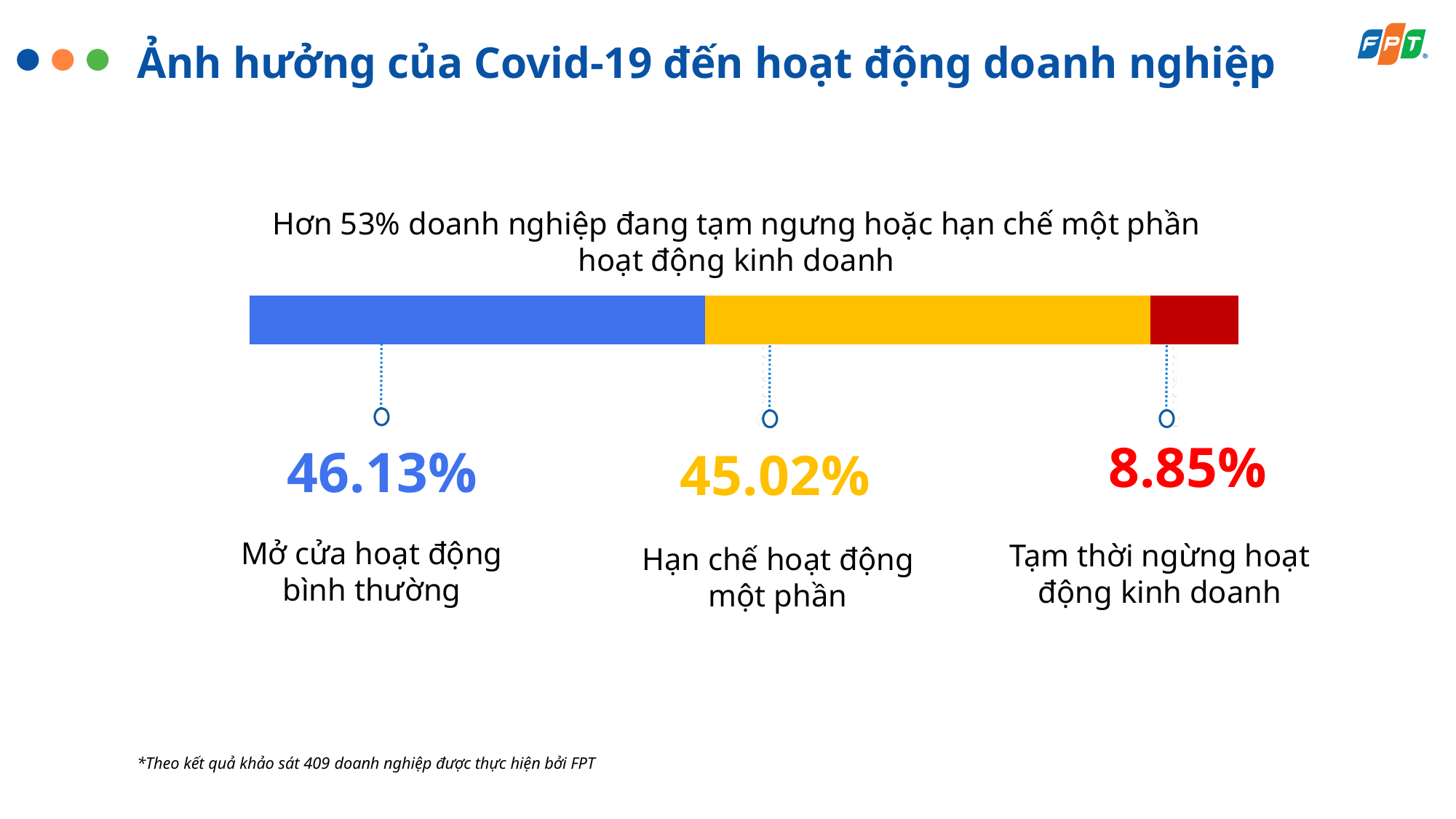
What kind of chart is shown on the slide? Stacked bar chart Which is larger: the share for "Hạn chế hoạt động một phần" or the share for "Tạm thời ngừng hoạt động kinh doanh"? Hạn chế hoạt động một phần What is the difference in percentage points between "Mở cửa hoạt động bình thường" and "Hạn chế hoạt động một phần"? 1.11 Which category has the lowest percentage? Tạm thời ngừng hoạt động kinh doanh What is the total of the three segments in the stacked bar? 100.00% What colour is the segment for "Tạm thời ngừng hoạt động kinh doanh"? Red What percentage of businesses are in the "Hạn chế hoạt động một phần" category? 45.02% Which category has the highest percentage? Mở cửa hoạt động bình thường How many categories are shown in the bar? 3 What percentage of businesses are in the "Mở cửa hoạt động bình thường" category? 46.13% What percentage of businesses are in the "Tạm thời ngừng hoạt động kinh doanh" category? 8.85% What is the difference in percentage points between "Hạn chế hoạt động một phần" and "Tạm thời ngừng hoạt động kinh doanh"? 36.17